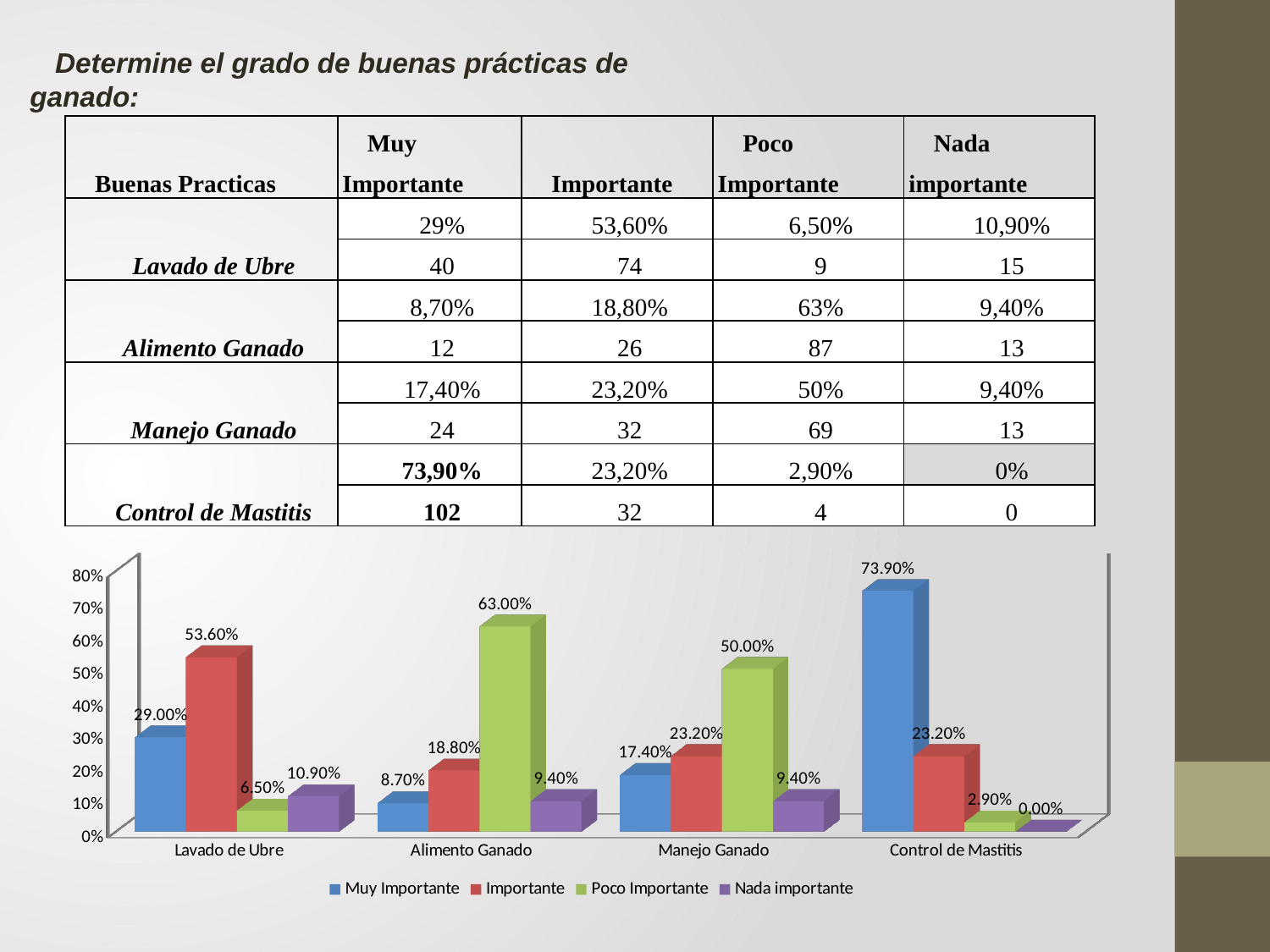
How many categories are shown on the x axis of the chart? 4 Which category has the lowest Nada importante value in the chart? Control de Mastitis What is the value for Poco Importante for Alimento Ganado in the chart? 63.00% How many series does the chart legend list? 4 Which is larger in the chart: Importante for Lavado de Ubre or Poco Importante for Manejo Ganado? Importante for Lavado de Ubre What is the value for Muy Importante for Control de Mastitis in the chart? 73.90% Which series is shown in green in the chart legend? Poco Importante What is the difference between the Poco Importante values for Alimento Ganado and Manejo Ganado in the chart? 13.00% What type of chart is shown on the slide? Bar chart What is the value for Nada importante for Manejo Ganado in the chart? 9.40% Which category has the highest Muy Importante value in the chart? Control de Mastitis What is the value for Importante for Lavado de Ubre in the chart? 53.60%